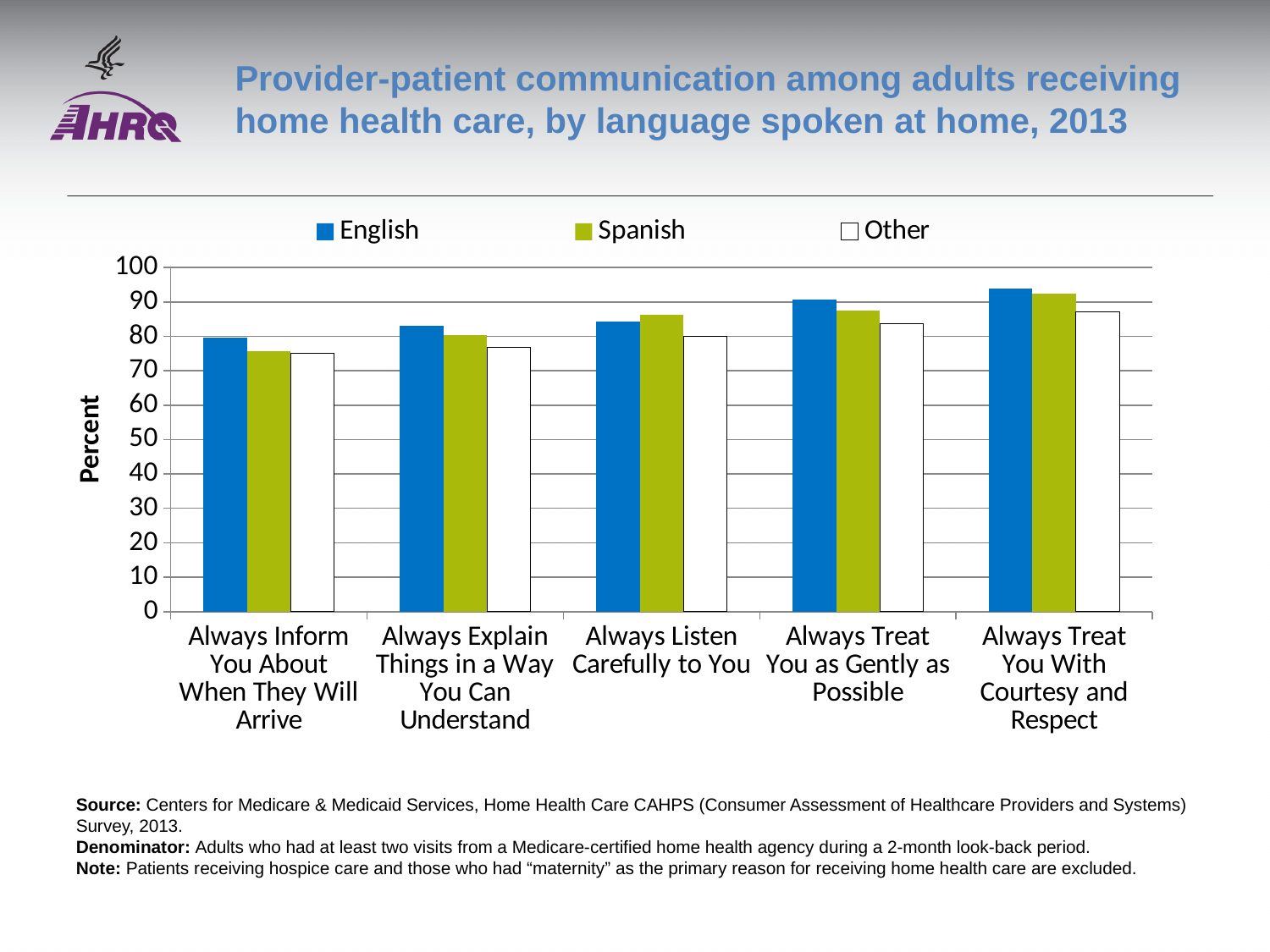
Is the Spanish value for Always Treat You With Courtesy and Respect greater or less than 90? greater Do the English values rise or fall moving from left to right across the categories? Rise What kind of chart is shown on the slide? Bar chart How many categories are shown along the x axis? 5 For which category is the English value lowest? Always Inform You About When They Will Arrive For Always Treat You as Gently as Possible, which is larger, the English value or the Other value? English What colour represents the Spanish series in the legend? Green Is the Other value for Always Inform You About When They Will Arrive greater or less than 80? less How many series does the legend list? 3 Is the English value for Always Treat You as Gently as Possible greater or less than 80? greater What is the label on the vertical axis? Percent For which category is the English value highest? Always Treat You With Courtesy and Respect